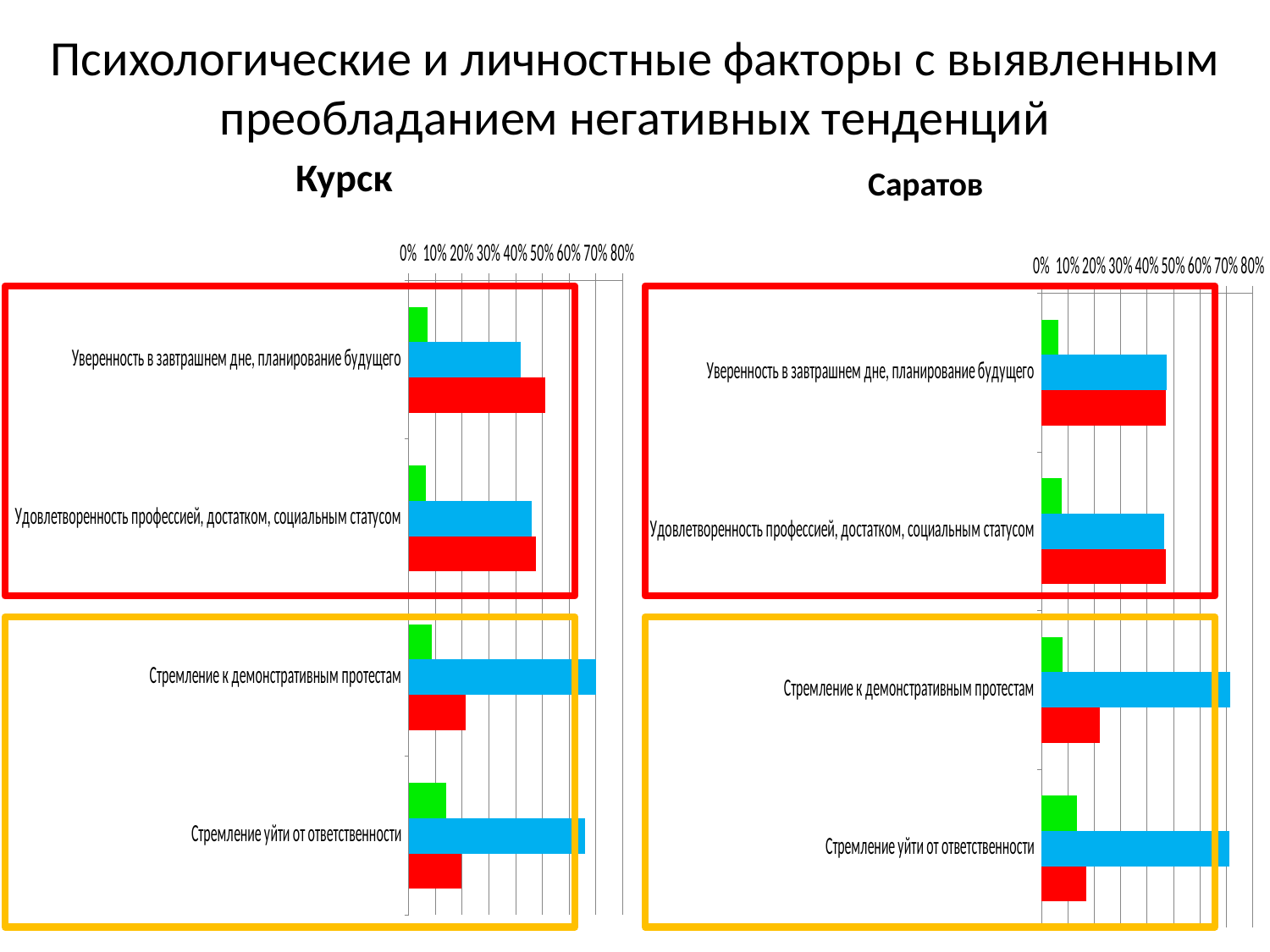
How many bars are plotted for each category in the Курск chart? 3 In the Саратов chart, is the blue bar for "Стремление уйти от ответственности" greater or less than 60%? greater What kind of chart is the Курск chart? bar chart How many categories does the Саратов chart show? 4 In the Курск chart, which category has the longest green bar? Стремление уйти от ответственности In the Курск chart, for "Уверенность в завтрашнем дне, планирование будущего", which bar is longer, the red one or the blue one? the red one In the Курск chart, for "Стремление к демонстративным протестам", which bar is longer, the blue one or the red one? the blue one What are the titles of the two charts on the slide? Курск and Саратов In the Курск chart, is the blue bar for "Стремление к демонстративным протестам" greater or less than 60%? greater In the Курск chart, is the red bar for "Уверенность в завтрашнем дне, планирование будущего" greater or less than 40%? greater In the Саратов chart, which category has the longest green bar? Стремление уйти от ответственности